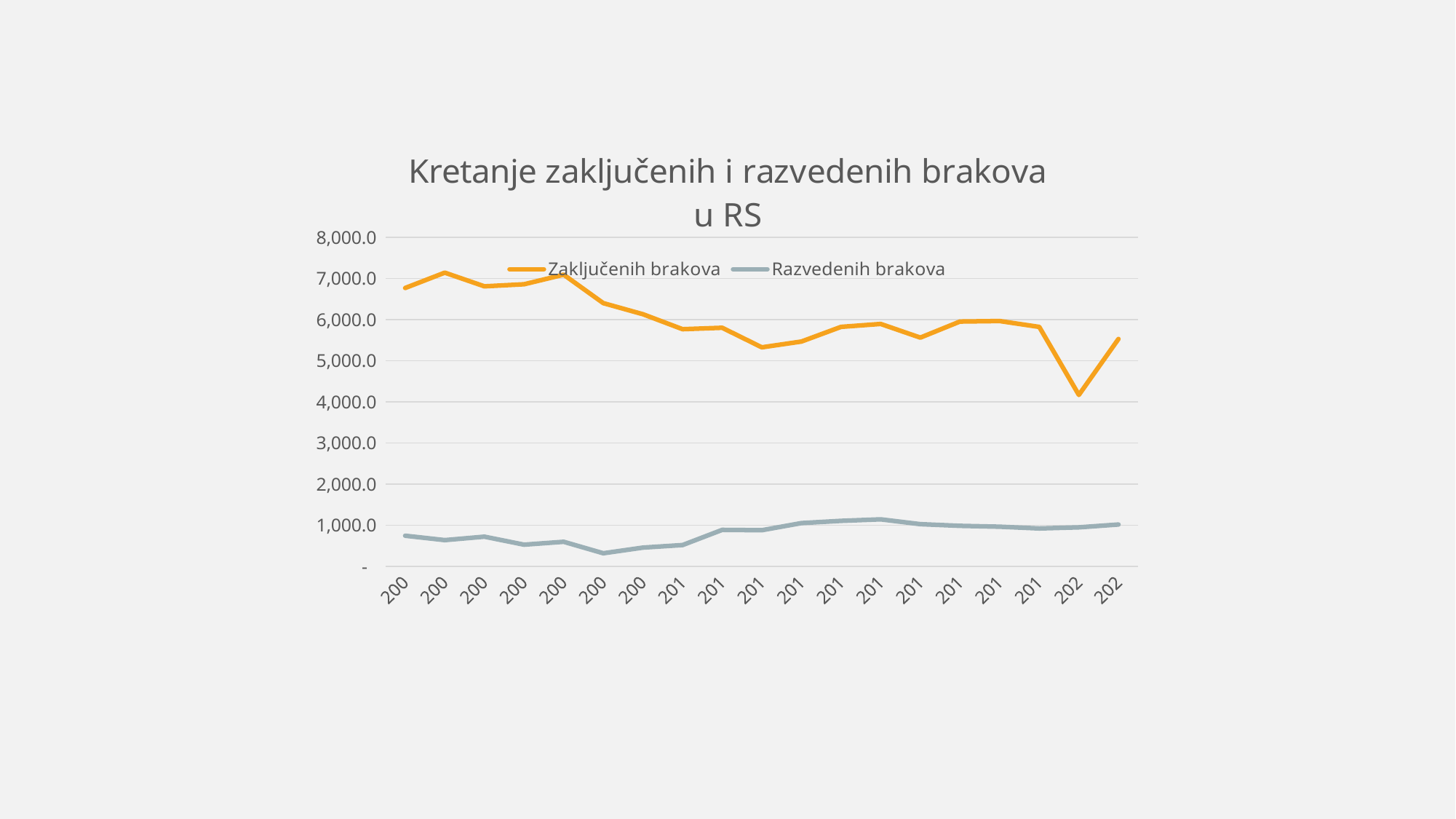
Is the first value of Zaključenih brakova greater or less than 6,000.0? greater Does the lowest point of the Zaključenih brakova line occur near the start or near the end of the x axis? near the end Is the first value of Razvedenih brakova greater or less than 1,000.0? less Which two series are listed in the legend? Zaključenih brakova and Razvedenih brakova Does the Razvedenih brakova line overall rise or fall from left to right? rise How many series does the legend list? 2 Is the lowest value of Zaključenih brakova greater or less than 5,000.0? less Which series has the higher values across the whole chart, Zaključenih brakova or Razvedenih brakova? Zaključenih brakova Does the Zaključenih brakova line overall rise or fall from left to right? fall What kind of chart is shown on the slide? line chart How many data points does each line have along the x axis? 19 What is the title of the chart? Kretanje zaključenih i razvedenih brakova u RS